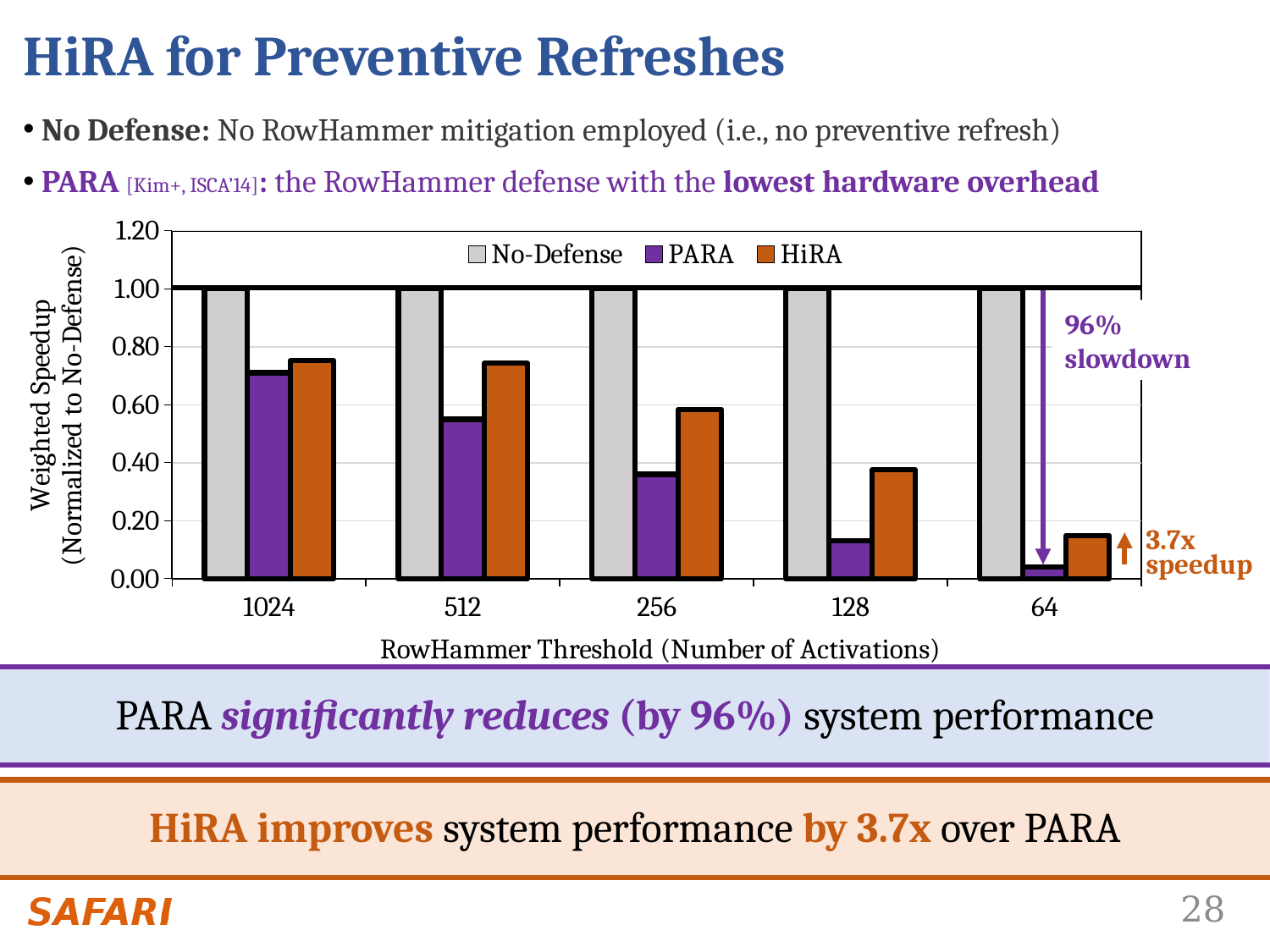
What kind of chart is shown on the slide? bar chart What is the x-axis title of the chart? RowHammer Threshold (Number of Activations) Do the PARA values rise or fall as the RowHammer threshold goes from 1024 to 64 along the x axis? fall How many series does the chart legend list? 3 Is the PARA value at a RowHammer threshold of 128 greater or less than 0.20? less What slowdown percentage is annotated on the chart for PARA at a threshold of 64? 96% At which RowHammer threshold is the PARA weighted speedup lowest? 64 At a RowHammer threshold of 256, which is larger, PARA or HiRA? HiRA What is the weighted speedup of No-Defense at a RowHammer threshold of 1024? 1.00 Is the PARA value at a RowHammer threshold of 512 greater or less than 0.60? less Is the HiRA value at a RowHammer threshold of 256 greater or less than 0.40? greater How many RowHammer threshold categories are shown on the x axis? 5